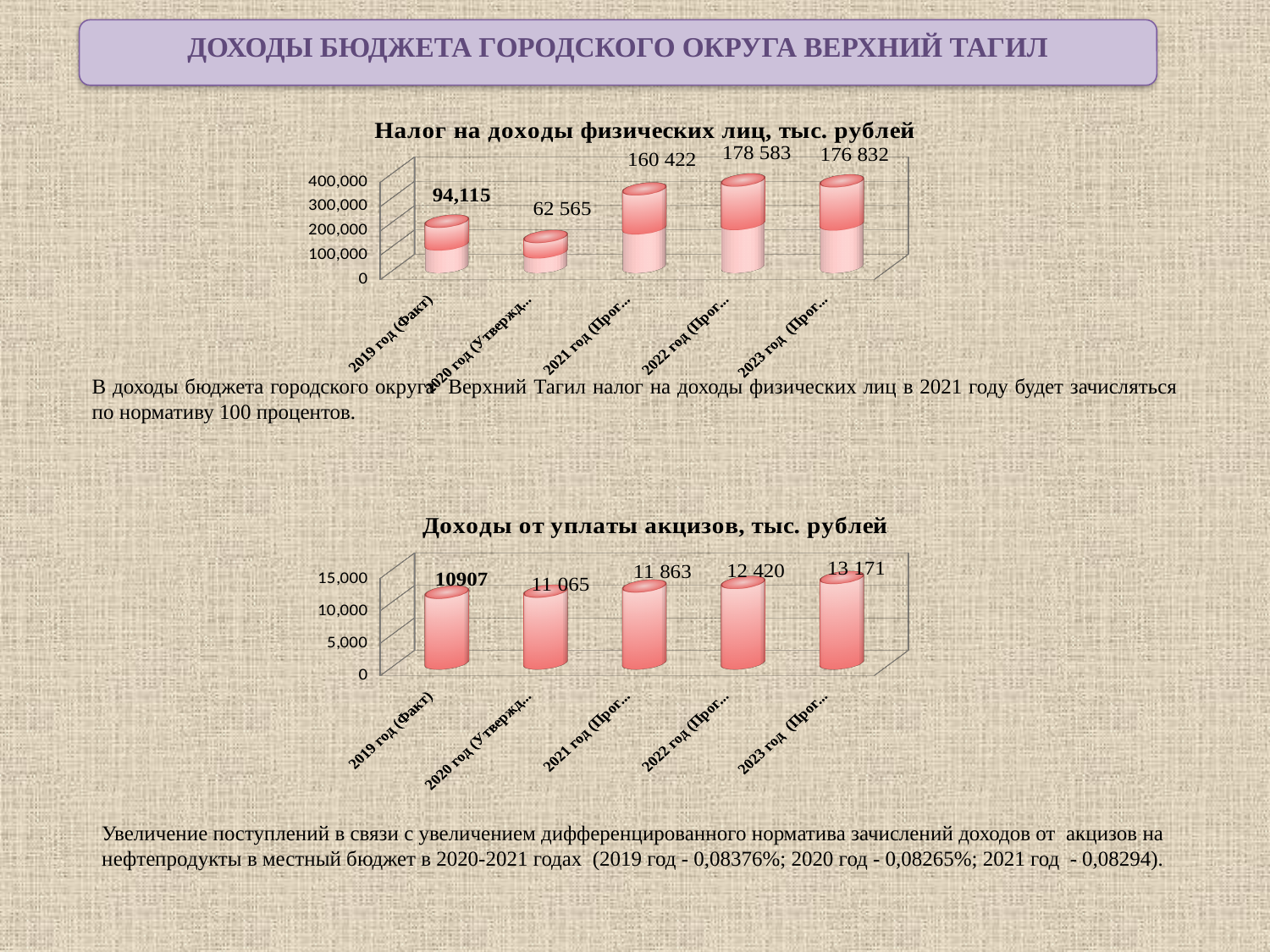
On the chart 'Доходы от уплаты акцизов, тыс. рублей', do the values rise or fall from 2019 to 2023? rise On the chart 'Налог на доходы физических лиц, тыс. рублей', which category has the highest value? 2022 год (Прог...) On the chart 'Доходы от уплаты акцизов, тыс. рублей', what is the value for 2023 год? 13 171 What kind of chart is the bottom chart 'Доходы от уплаты акцизов, тыс. рублей'? bar chart On the chart 'Налог на доходы физических лиц, тыс. рублей', which category has the lowest value? 2020 год (Утвержд...) On the chart 'Налог на доходы физических лиц, тыс. рублей', is the value for 2020 год greater or less than 100,000? less On the chart 'Доходы от уплаты акцизов, тыс. рублей', which is larger, the value for 2020 год or 2022 год? 2022 год On the chart 'Налог на доходы физических лиц, тыс. рублей', what is the value for 2019 год (Факт)? 94,115 On the chart 'Налог на доходы физических лиц, тыс. рублей', what is the value for 2021 год? 160 422 On the chart 'Доходы от уплаты акцизов, тыс. рублей', what is the difference between the values for 2022 год and 2021 год? 557 On the chart 'Налог на доходы физических лиц, тыс. рублей', how many categories are plotted? 5 On the chart 'Доходы от уплаты акцизов, тыс. рублей', what is the value for 2019 год (Факт)? 10907